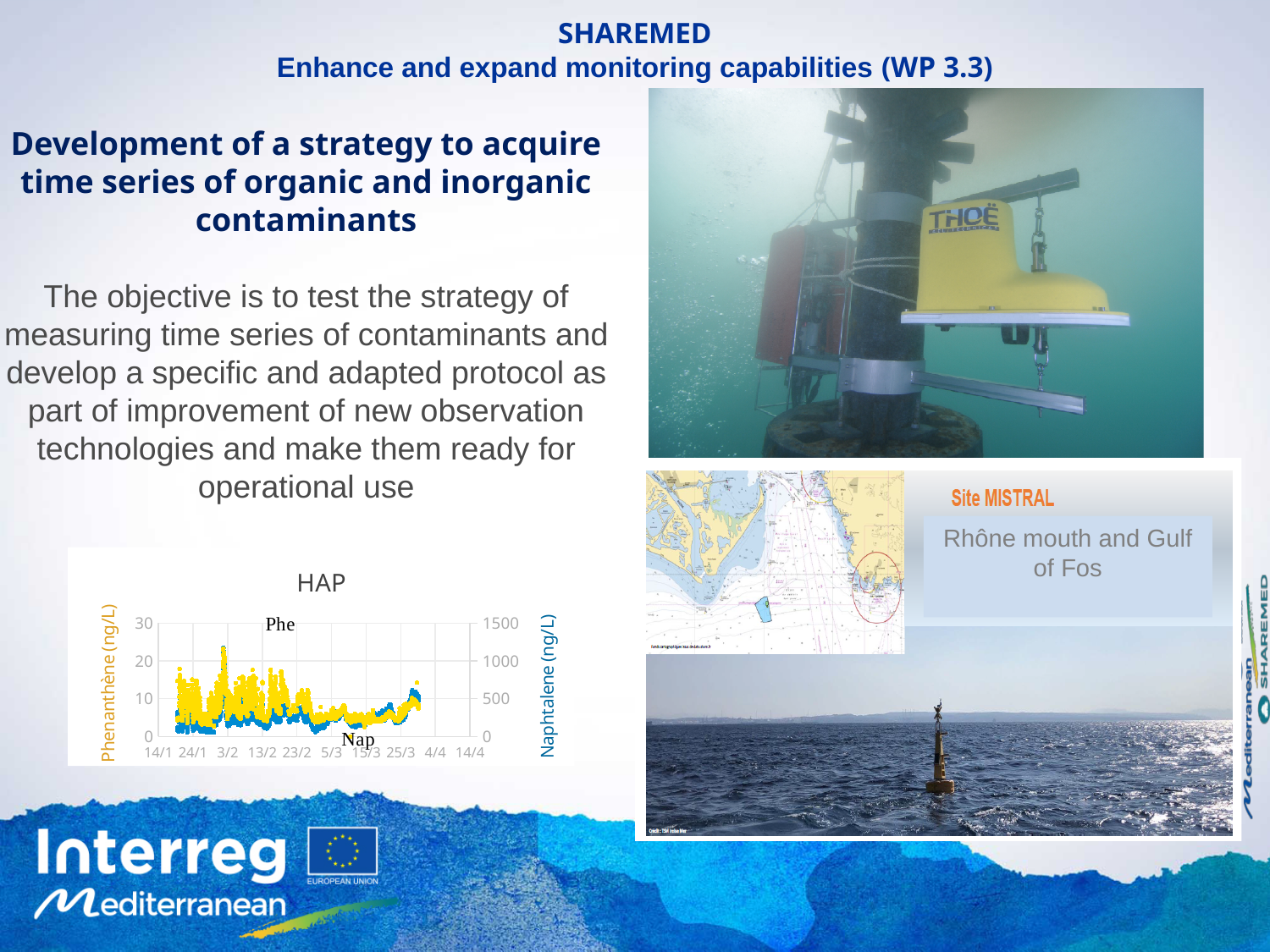
Is the highest Phe value in the HAP chart greater or less than 30? less How many data series are plotted in the HAP chart? 2 What is the title of the chart on the slide? HAP What kind of chart is the HAP chart? scatter chart Is the peak Phe value near 3/2 in the HAP chart greater or less than 20? greater What colour are the Phe points in the HAP chart? yellow How many date ticks are shown on the x axis of the HAP chart? 10 Between 3/2 and 5/3, do the Phe values in the HAP chart generally rise or fall? fall